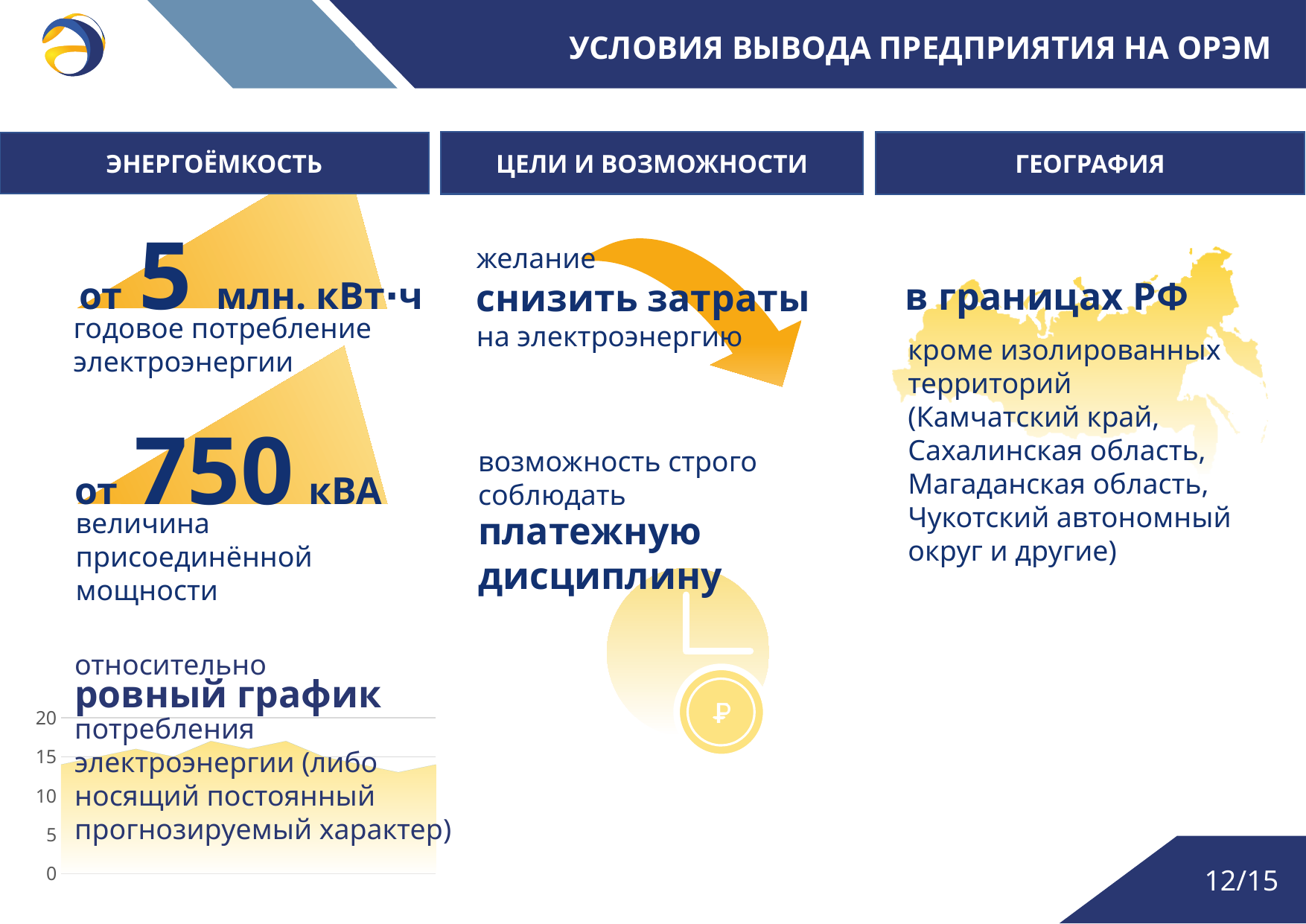
How many tick labels are shown on the vertical axis of the chart at the bottom left? 5 On the chart at the bottom left, is the highest point of the plotted area greater or less than 10? greater What kind of chart is shown at the bottom left of the slide? area chart What is the highest value shown on the vertical axis of the chart at the bottom left? 20 On the chart at the bottom left, is the lowest point of the plotted area greater or less than 5? greater Does the chart at the bottom left show a legend? No On the chart at the bottom left, is the highest point of the plotted area greater or less than 20? less